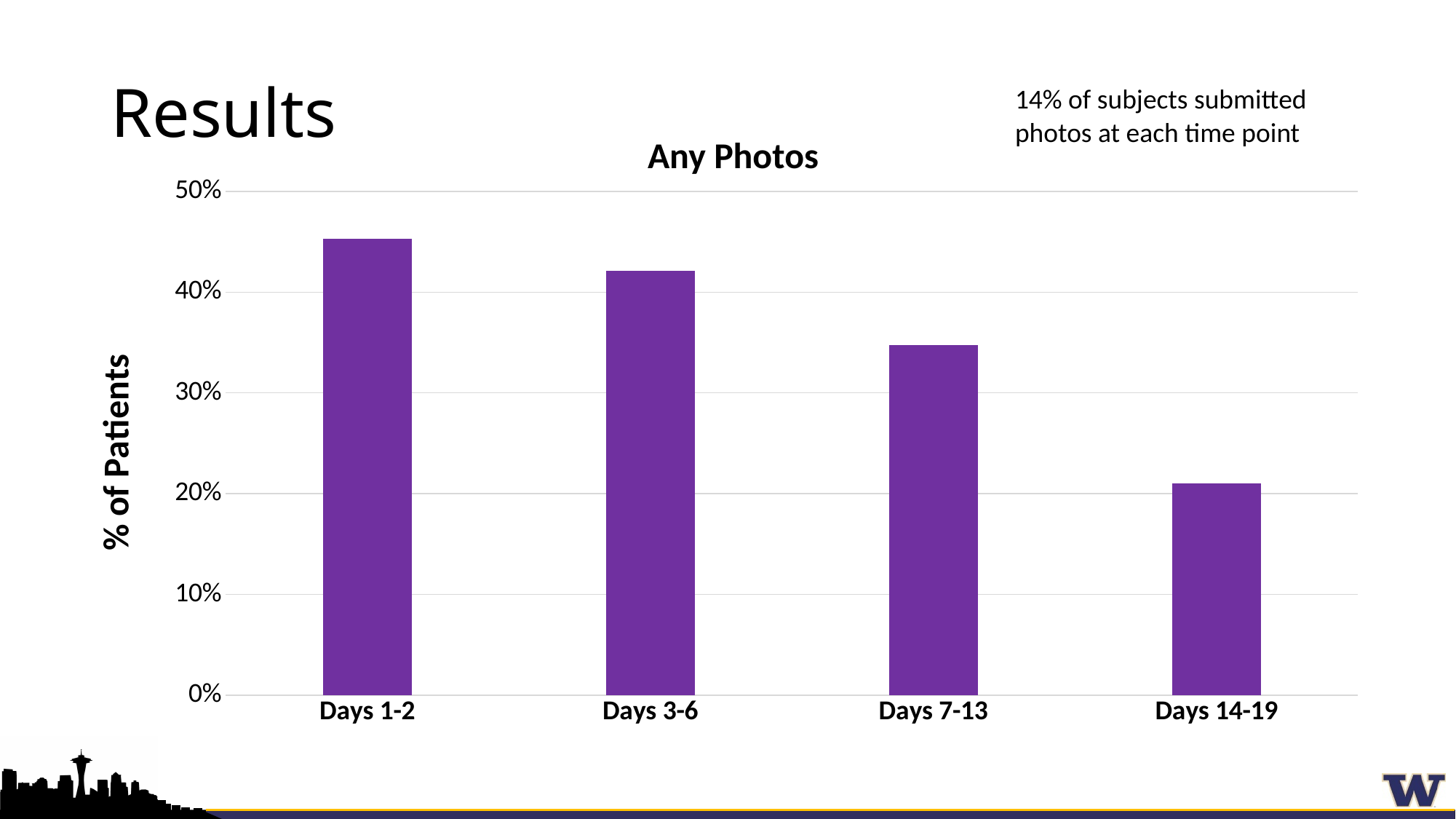
What is the label on the vertical axis of the chart? % of Patients What is the title of the chart? Any Photos What type of chart is shown on the slide? bar chart Which is larger, the value for Days 7-13 or the value for Days 14-19? Days 7-13 Is the value for Days 3-6 greater or less than 40%? greater Is the value for Days 1-2 greater or less than 40%? greater Do the values rise or fall moving from Days 1-2 to Days 14-19 along the x axis? fall How many categories are shown on the x axis of the chart? 4 Which category has the lowest value in the chart? Days 14-19 Which category has the highest value in the chart? Days 1-2 Is the value for Days 14-19 greater or less than 30%? less